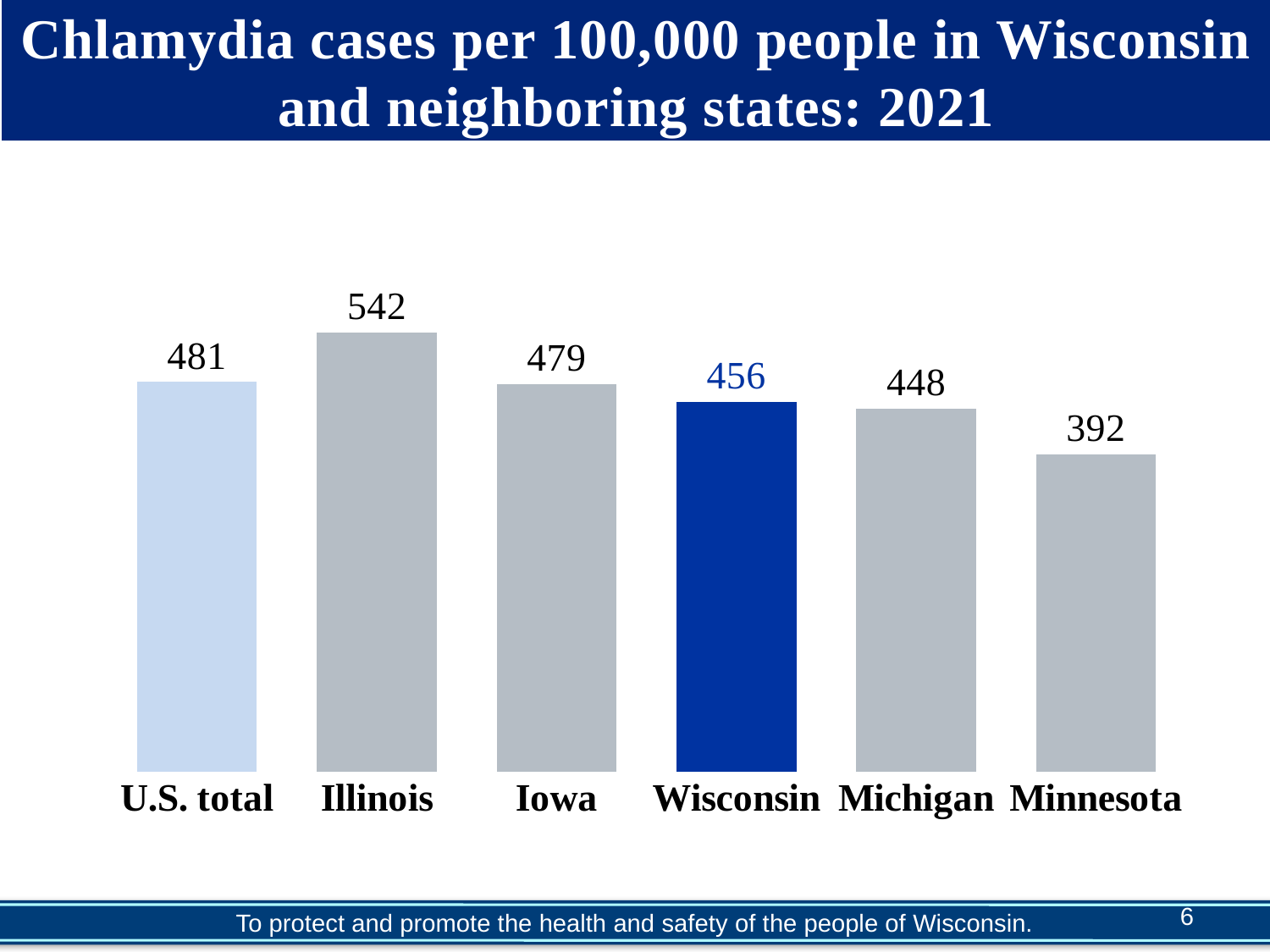
Which is larger, the value for Iowa or the value for Michigan? Iowa Which category has the lowest chlamydia rate? Minnesota What is the chlamydia rate per 100,000 people for Wisconsin? 456 What is the value shown for the U.S. total? 481 Which category has the highest chlamydia rate? Illinois How many categories are shown in the chart? 6 What kind of chart is shown on the slide? Bar chart What is the value shown for Minnesota? 392 Which bar is colored dark blue? Wisconsin What is the difference between the Illinois value and the Wisconsin value? 86 What is the difference between the U.S. total and Minnesota? 89 What is the value shown for Illinois? 542